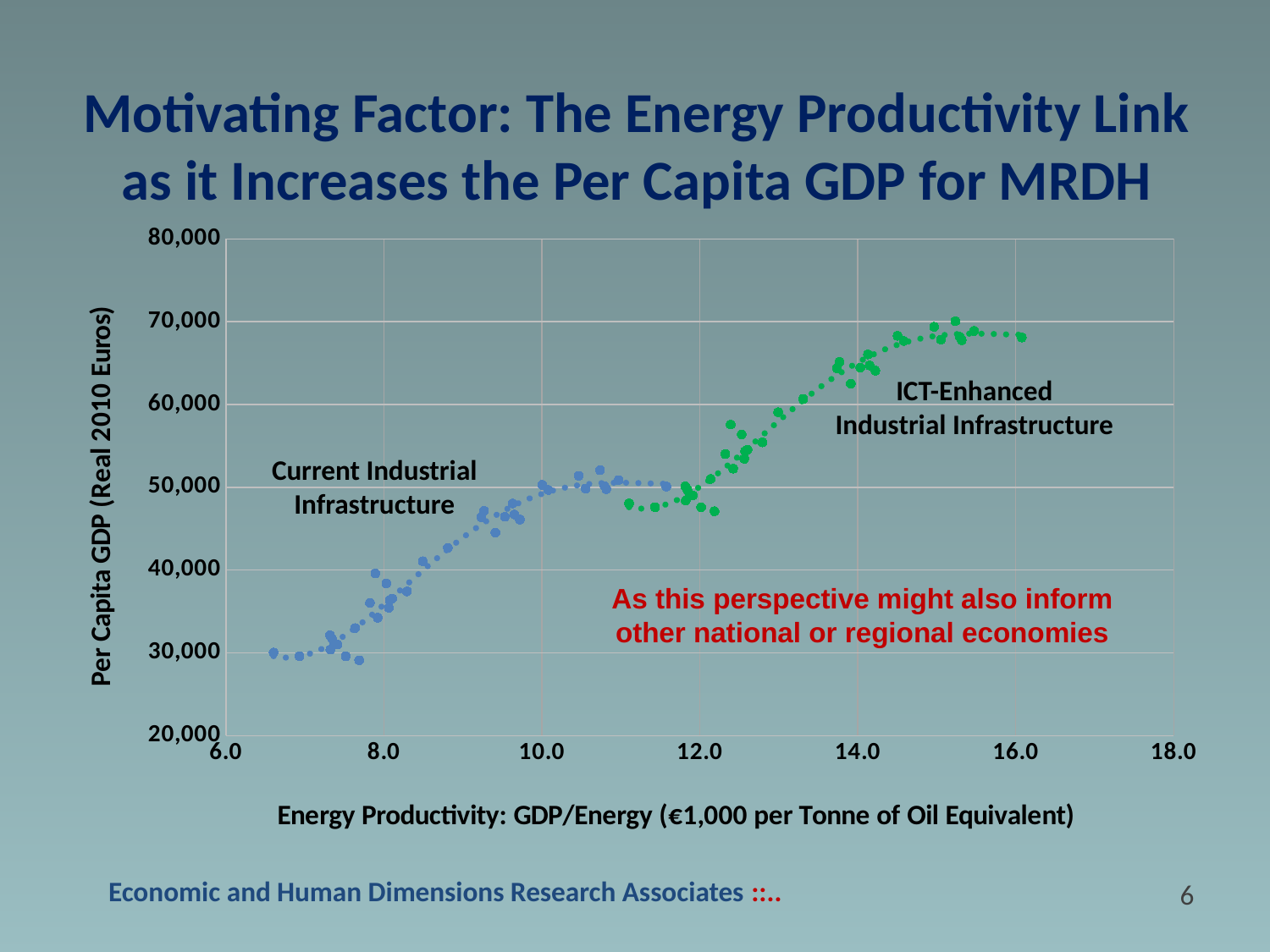
How many groups of points are labelled on the chart? 2 Is the per capita GDP for the green points near an energy productivity of 14.0 greater or less than 60,000? greater What is the title of the chart's horizontal axis? Energy Productivity: GDP/Energy (€1,000 per Tonne of Oil Equivalent) Is the per capita GDP for the blue points near an energy productivity of 9.0 greater or less than 50,000? less Which group of points has the higher per capita GDP values, Current Industrial Infrastructure or ICT-Enhanced Industrial Infrastructure? ICT-Enhanced Industrial Infrastructure Is the per capita GDP for the green points near an energy productivity of 16.0 greater or less than 70,000? less What is the title of the chart's vertical axis? Per Capita GDP (Real 2010 Euros) What kind of chart is shown on the slide? scatter chart What is the highest value shown on the vertical axis? 80,000 Overall, do the plotted per capita GDP values rise or fall as energy productivity increases along the x axis? rise